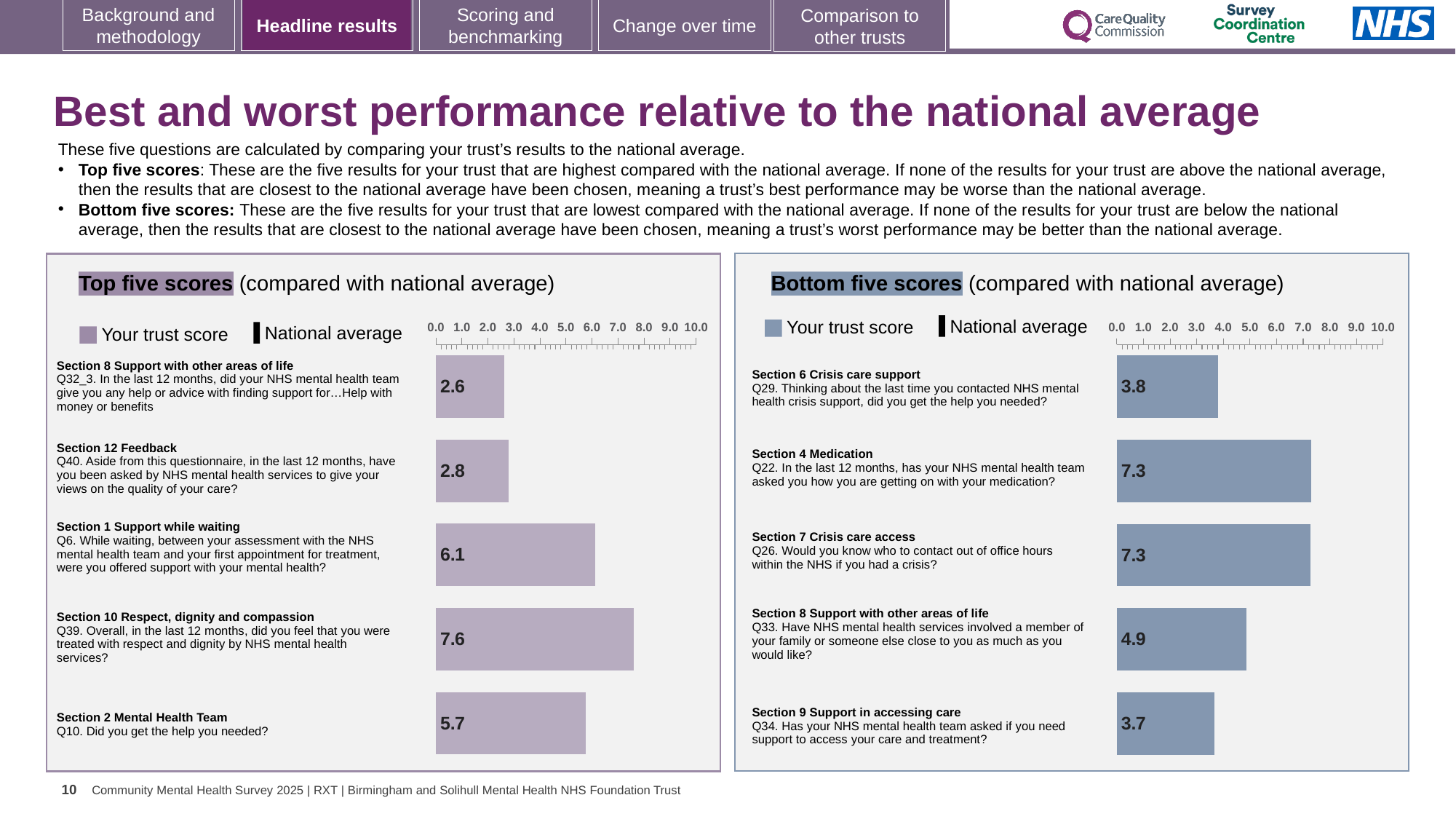
In the Top five scores chart, which has the larger trust score: Q6 or Q10? Q6 In the Bottom five scores chart, what is the trust score for Q29 (crisis care support)? 3.8 How many series does the legend of the Top five scores chart list? 2 How many questions are shown in the Bottom five scores chart? 5 In the Top five scores chart, what is the trust score for Q6 (support while waiting)? 6.1 In the Top five scores chart, which question has the highest trust score? Q39 (Section 10 Respect, dignity and compassion) What type of chart is the Bottom five scores chart? Bar chart In the Top five scores chart, which question has the lowest trust score? Q32_3 (Section 8 Support with other areas of life) In the Bottom five scores chart, what is the difference between the trust scores for Q22 and Q34? 3.6 In the Top five scores chart, what is the difference between the trust scores for Q39 and Q32_3? 5.0 In the Bottom five scores chart, what is the trust score for Q33 (involving family or someone close)? 4.9 In the Top five scores chart, what is the trust score for Q39 (treated with respect and dignity)? 7.6